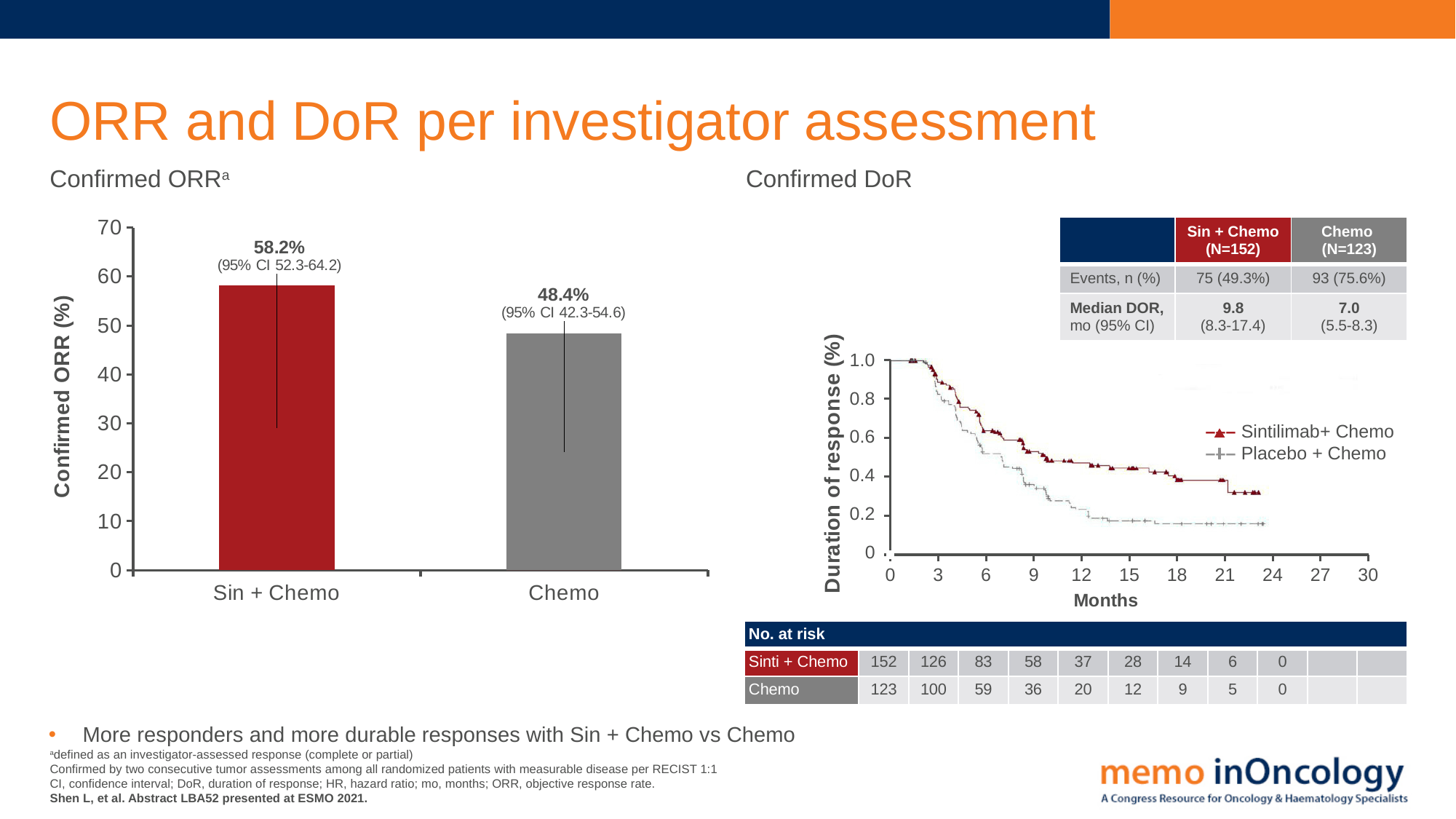
On the Confirmed ORR chart, what is the confirmed ORR for Chemo? 48.4% On the Confirmed ORR chart, what is the difference in confirmed ORR between Sin + Chemo and Chemo? 9.8 percentage points On the Confirmed ORR chart, which arm has the higher confirmed ORR? Sin + Chemo On the Confirmed DoR chart, do the curves rise or fall as months increase? Fall On the Confirmed ORR chart, how many arms are plotted? 2 On the Confirmed DoR chart, how many series does the legend list? 2 What kind of chart is the Confirmed ORR chart? Bar chart On the Confirmed ORR chart, is the value for Chemo greater or less than 40? greater On the Confirmed DoR chart, how many patients were at risk in the Sinti + Chemo arm at 6 months? 83 On the Confirmed ORR chart, what is the 95% CI shown for Sin + Chemo? 52.3-64.2 On the Confirmed DoR chart, is the value for Placebo + Chemo at 12 months greater or less than 0.4? less On the Confirmed ORR chart, what is the confirmed ORR for Sin + Chemo? 58.2%